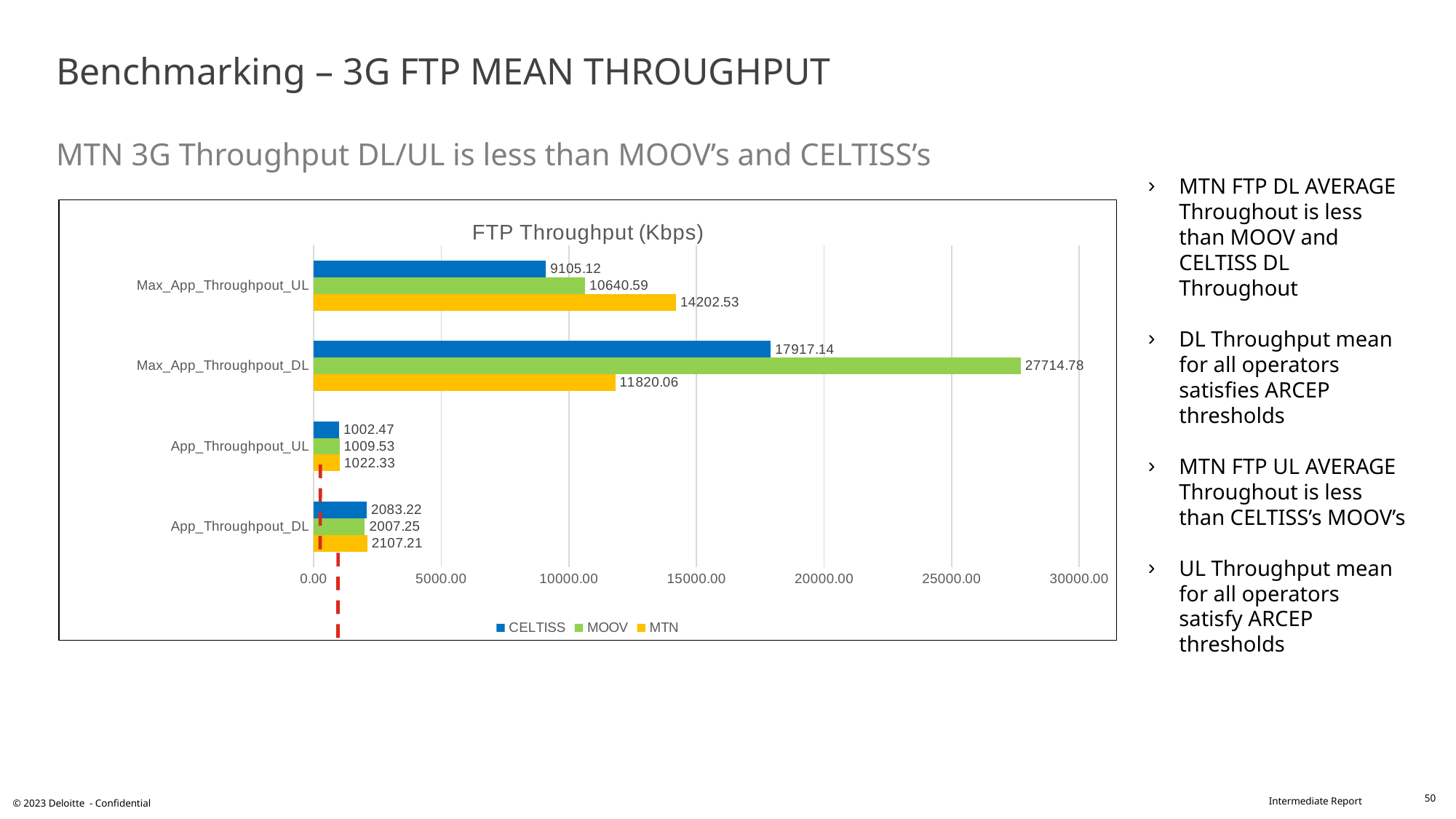
What is the difference between the MOOV and CELTISS values for Max_App_Throughpout_DL? 9797.64 What type of chart is shown on the slide? Bar chart How many series does the legend list? 3 What is the MTN value for Max_App_Throughpout_UL? 14202.53 Which operator has the lowest Max_App_Throughpout_UL value? CELTISS Which operator has the highest Max_App_Throughpout_DL value? MOOV What is the MOOV value for Max_App_Throughpout_DL? 27714.78 What is the CELTISS value for App_Throughpout_DL? 2083.22 For Max_App_Throughpout_DL, which is larger: the CELTISS value or the MTN value? CELTISS What is the title of the chart? FTP Throughput (Kbps) Is the CELTISS value for Max_App_Throughpout_DL greater or less than 15000.00? greater How many categories are shown on the chart's vertical axis? 4